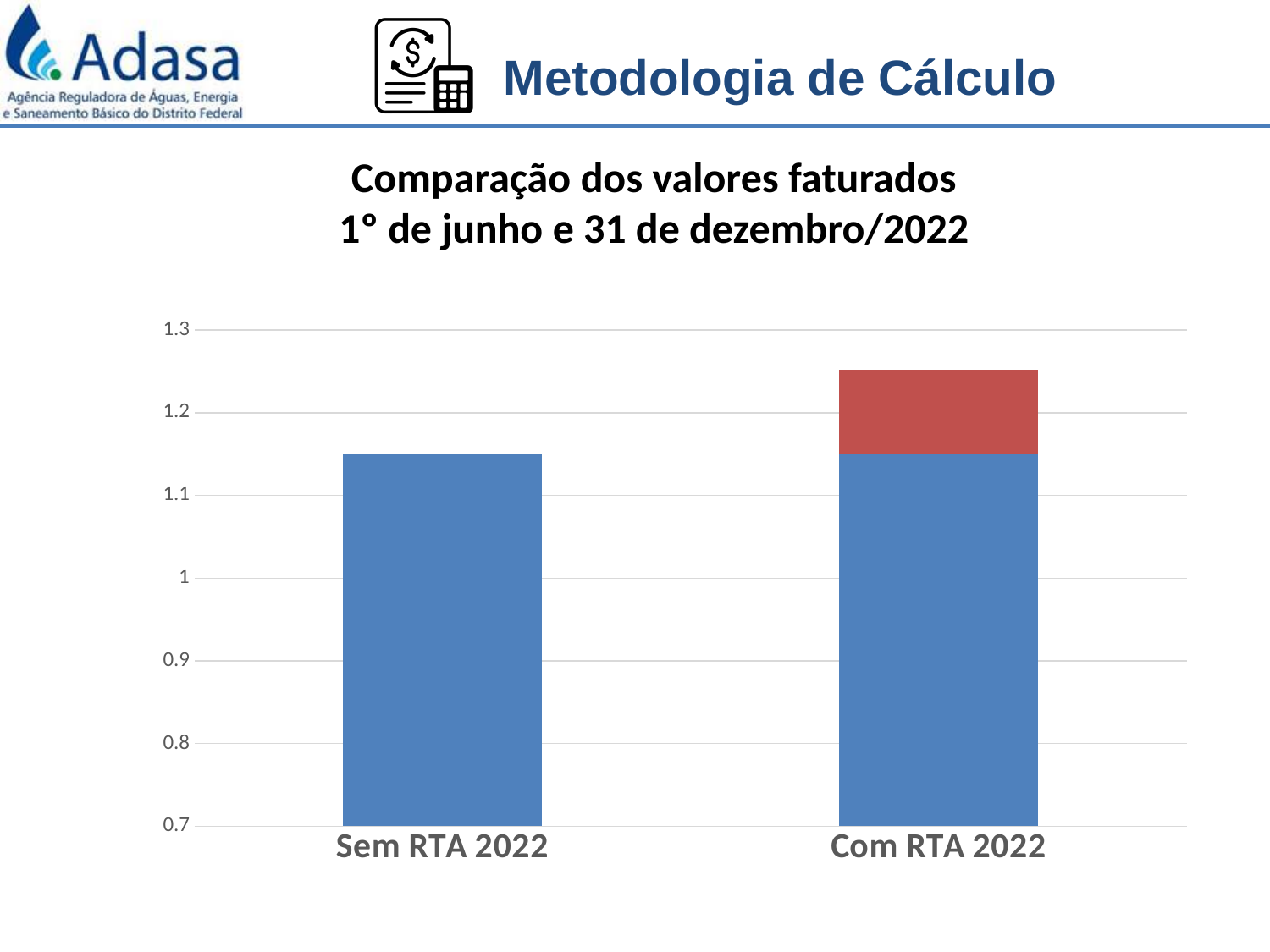
What is the lowest value shown on the y axis? 0.7 Is the value for Sem RTA 2022 greater or less than 1.2? less Is the value for Sem RTA 2022 greater or less than 1.1? greater Which category has the lowest total bar? Sem RTA 2022 What is the title of the chart? Comparação dos valores faturados 1° de junho e 31 de dezembro/2022 Which category has the taller bar, Sem RTA 2022 or Com RTA 2022? Com RTA 2022 Is the total value for Com RTA 2022 greater or less than 1.2? greater Which category has the highest total bar? Com RTA 2022 What kind of chart is shown on the slide? bar chart How many categories are shown on the x axis of the chart? 2 Which category's bar includes a red segment on top? Com RTA 2022